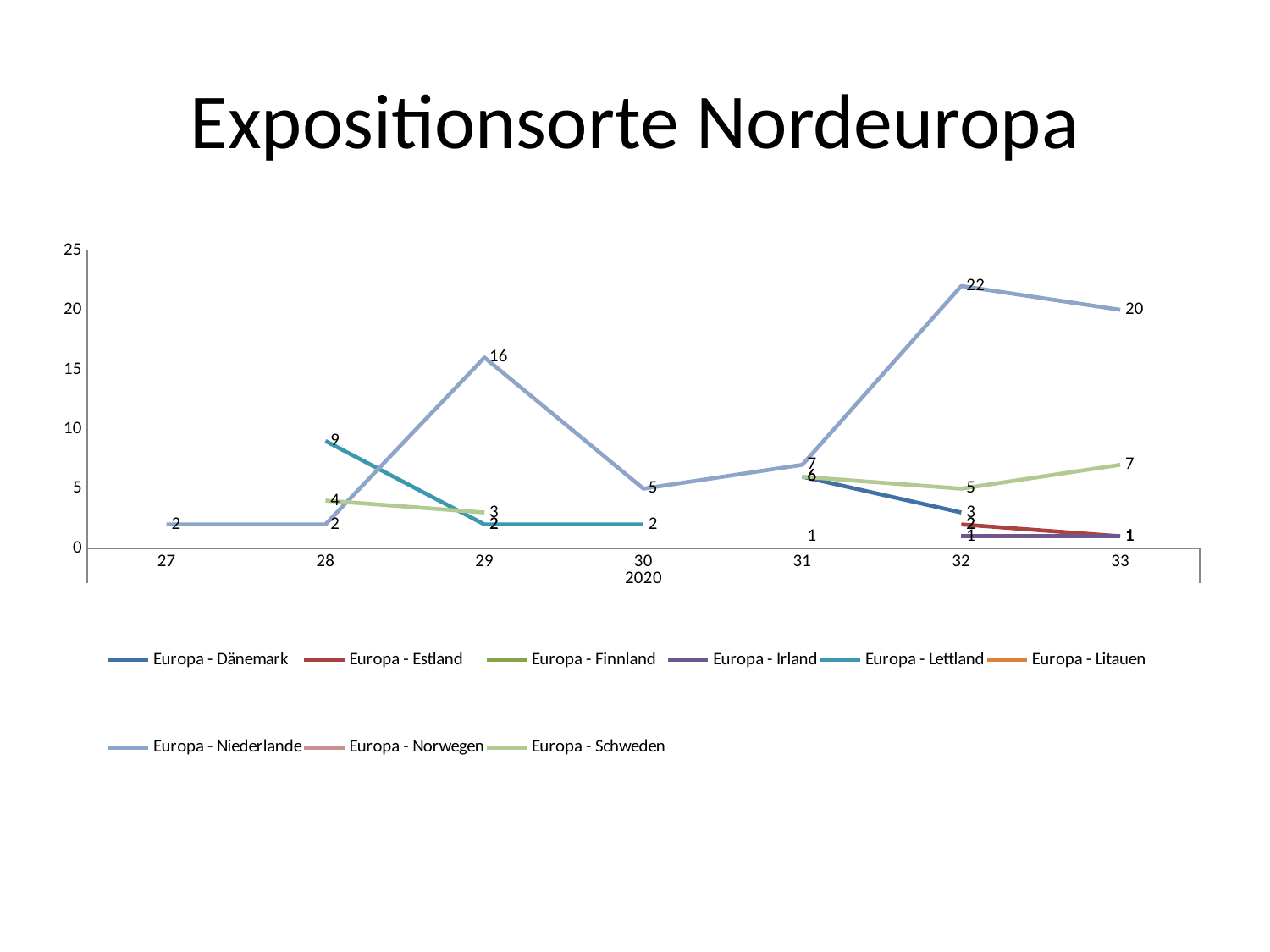
What is the difference between the Europa - Niederlande values in week 32 and week 33? 2 What is the title of the slide? Expositionsorte Nordeuropa How many series does the legend list? 9 Is the value for Europa - Niederlande in week 33 greater or less than 15? greater What is the value for Europa - Niederlande in week 32? 22 In which week does Europa - Niederlande reach its highest value? 32 Which is larger for Europa - Niederlande: the value in week 29 or the value in week 30? week 29 What is the value for Europa - Niederlande in week 29? 16 How many weeks are shown on the x axis? 7 What is the value for Europa - Lettland in week 28? 9 What is the value for Europa - Schweden in week 33? 7 What kind of chart is shown on the slide? line chart